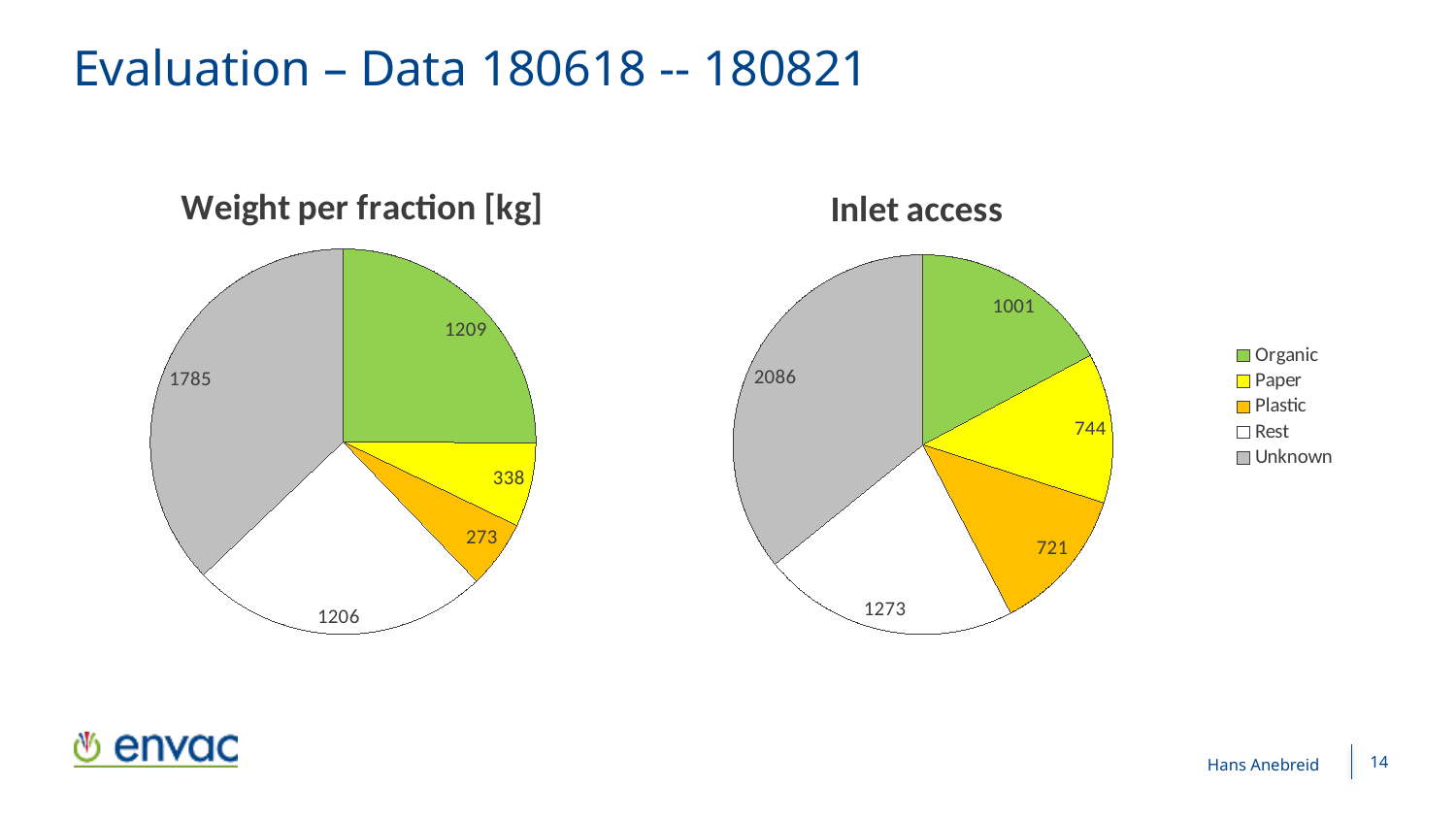
In the "Weight per fraction [kg]" chart, what is the difference between the Unknown and Organic values? 576 In the "Weight per fraction [kg]" chart, which category has the smallest slice? Plastic In the "Weight per fraction [kg]" chart, which category has the largest slice? Unknown How many categories does the legend list? 5 In the "Inlet access" chart, what is the difference between the Unknown and Rest values? 813 What kind of chart is the "Weight per fraction [kg]" chart? pie chart In the "Inlet access" chart, what is the value for Paper? 744 In the "Inlet access" chart, what is the value for Rest? 1273 In the "Inlet access" chart, which category has the largest slice? Unknown In the "Weight per fraction [kg]" chart, what is the value for Plastic? 273 In the "Inlet access" chart, which is larger, the value for Organic or the value for Plastic? Organic In the "Weight per fraction [kg]" chart, what is the value for Organic? 1209